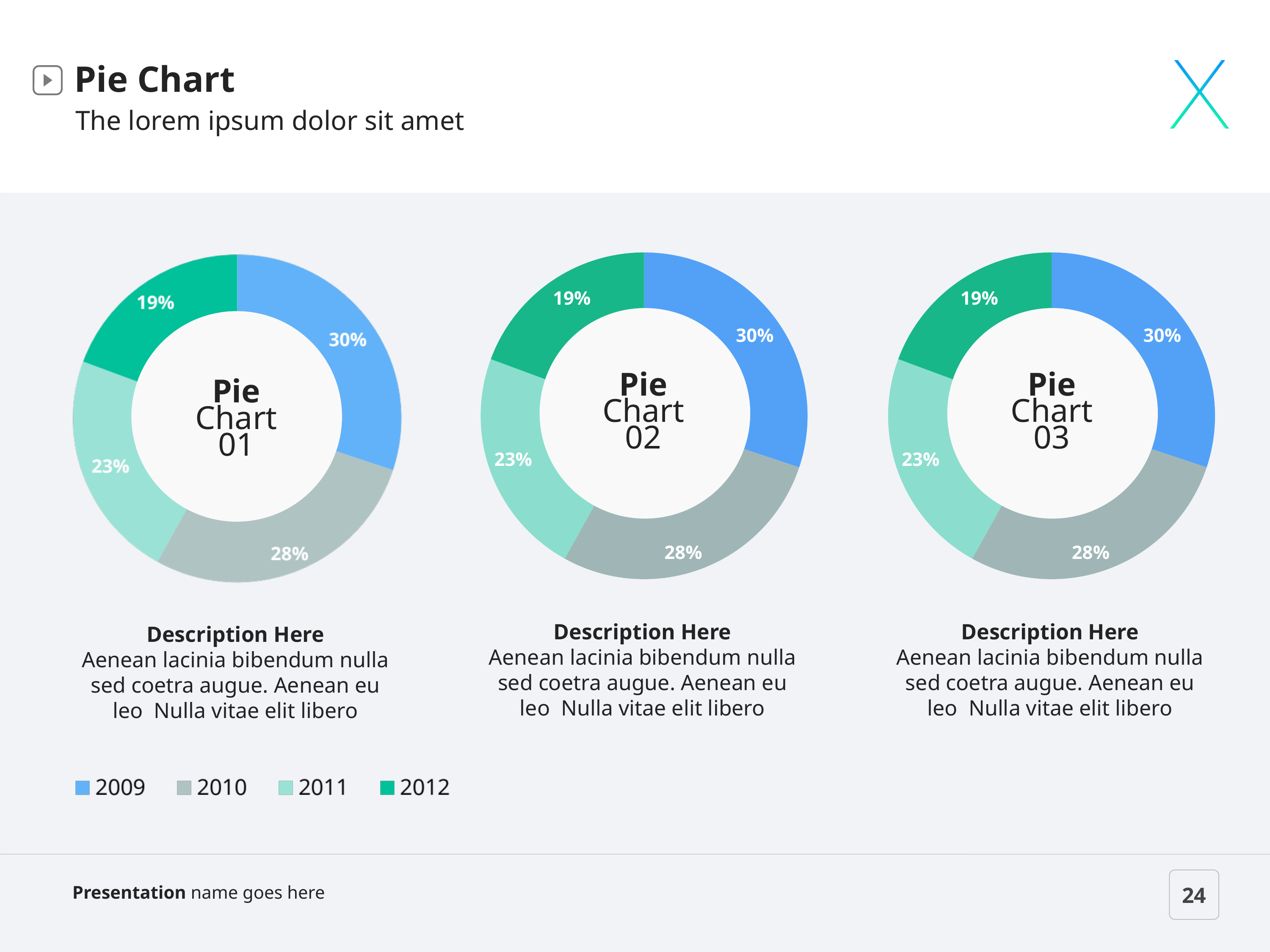
In Pie Chart 02, which is larger, the share for 2010 or the share for 2011? 2010 In Pie Chart 03, what is the value for 2012? 19% What kind of chart is Pie Chart 01? Pie chart In Pie Chart 01, what is the difference between the shares for 2009 and 2012? 11% How many entries does the legend at the bottom of the slide list? 4 In Pie Chart 03, which year has the smallest share? 2012 In Pie Chart 01, what is the value for 2009? 30% In Pie Chart 02, what is the value for 2011? 23% Which colour represents 2012 in the legend? Green In Pie Chart 01, what is the value for 2010? 28% In Pie Chart 02, which year has the largest share? 2009 How many slices does Pie Chart 03 have? 4